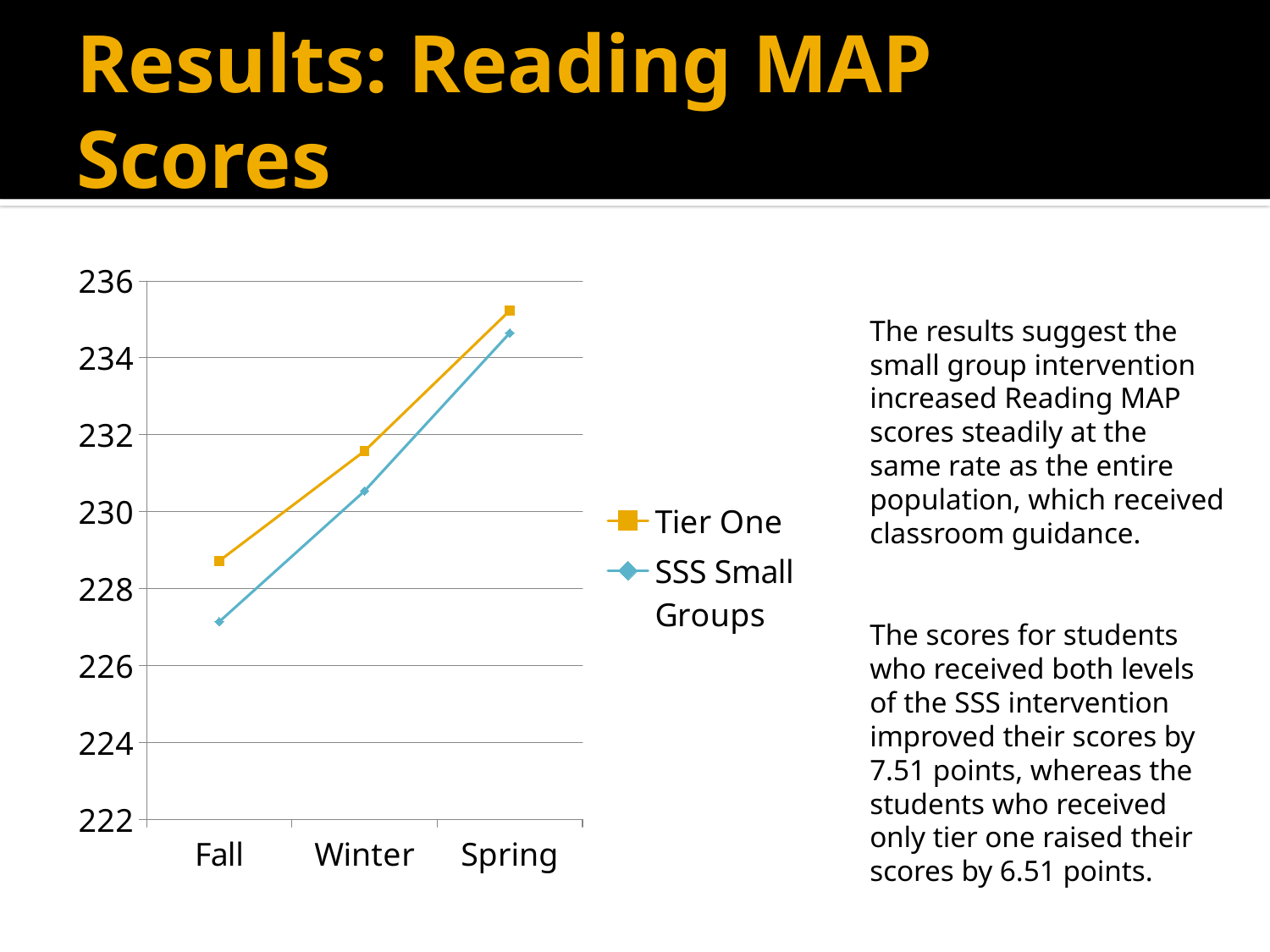
Which series is drawn in orange with square markers? Tier One In Winter, which series has the higher score, Tier One or SSS Small Groups? Tier One How many categories are shown on the x axis? 3 In Fall, which series has the higher score, Tier One or SSS Small Groups? Tier One What kind of chart is shown on the slide? line chart How many series does the legend list? 2 In which category is the SSS Small Groups score lowest? Fall In which category is the Tier One score highest? Spring Do the Tier One scores rise or fall from Fall to Spring? rise Is the SSS Small Groups value for Fall greater or less than 228? less Is the Tier One value for Spring greater or less than 234? greater Do the SSS Small Groups scores rise or fall from Fall to Spring? rise